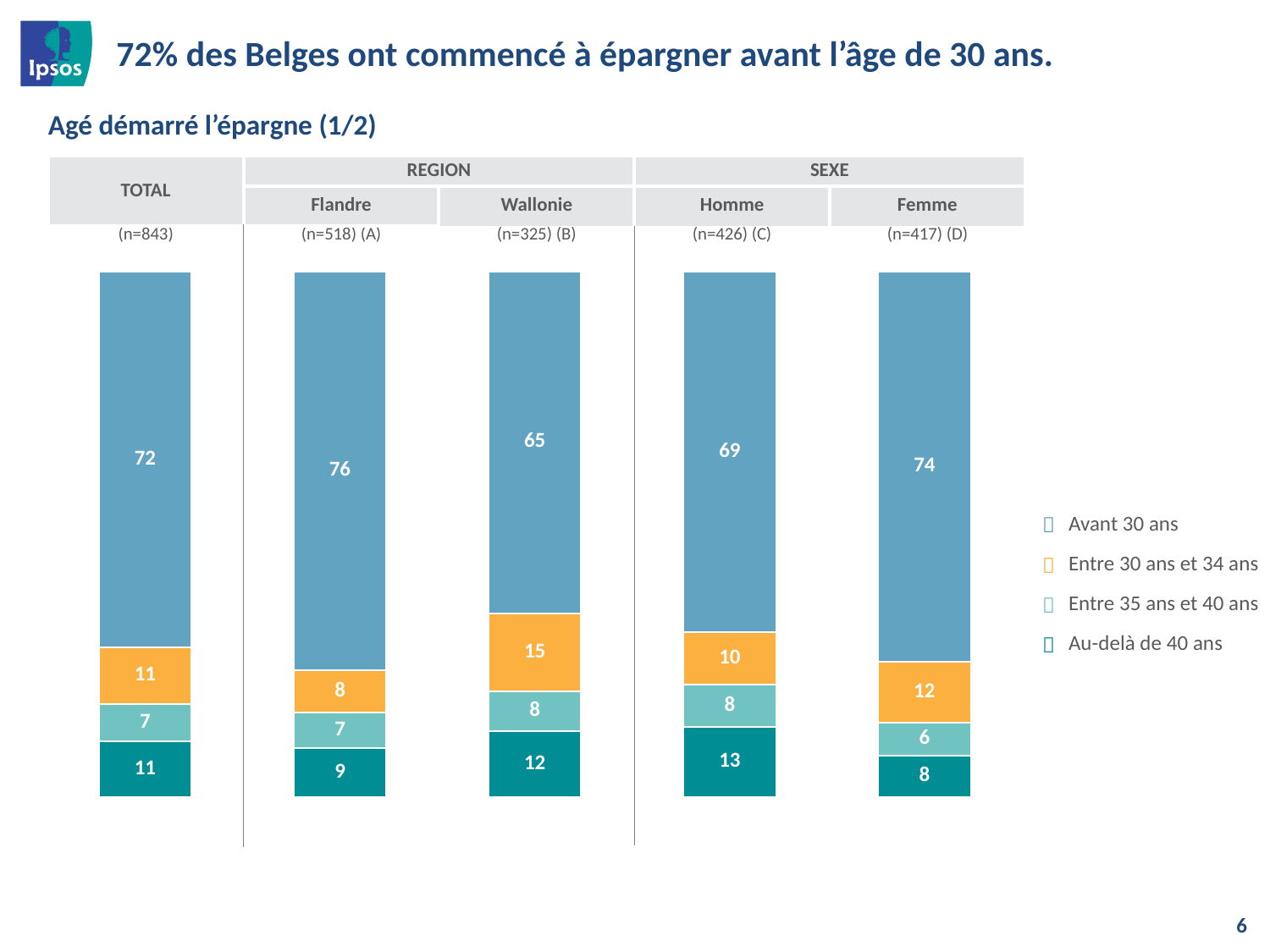
What is the value of the 'Avant 30 ans' segment for Wallonie? 65 What type of chart is shown on the slide? stacked bar chart Which category has the lowest 'Avant 30 ans' value? Wallonie What is the value of the 'Au-delà de 40 ans' segment for Homme? 13 Which category has the highest 'Avant 30 ans' value? Flandre How many series does the legend list? 4 What is the sample size (n) shown for Wallonie? 325 What is the value of the 'Entre 30 ans et 34 ans' segment for Femme? 12 How many bars (categories) are plotted in the chart? 5 Which is larger: the 'Entre 30 ans et 34 ans' value for Homme or for Femme? Femme What is the total of the stacked bar for TOTAL? 101 What is the difference between the 'Avant 30 ans' values for Flandre and Wallonie? 11